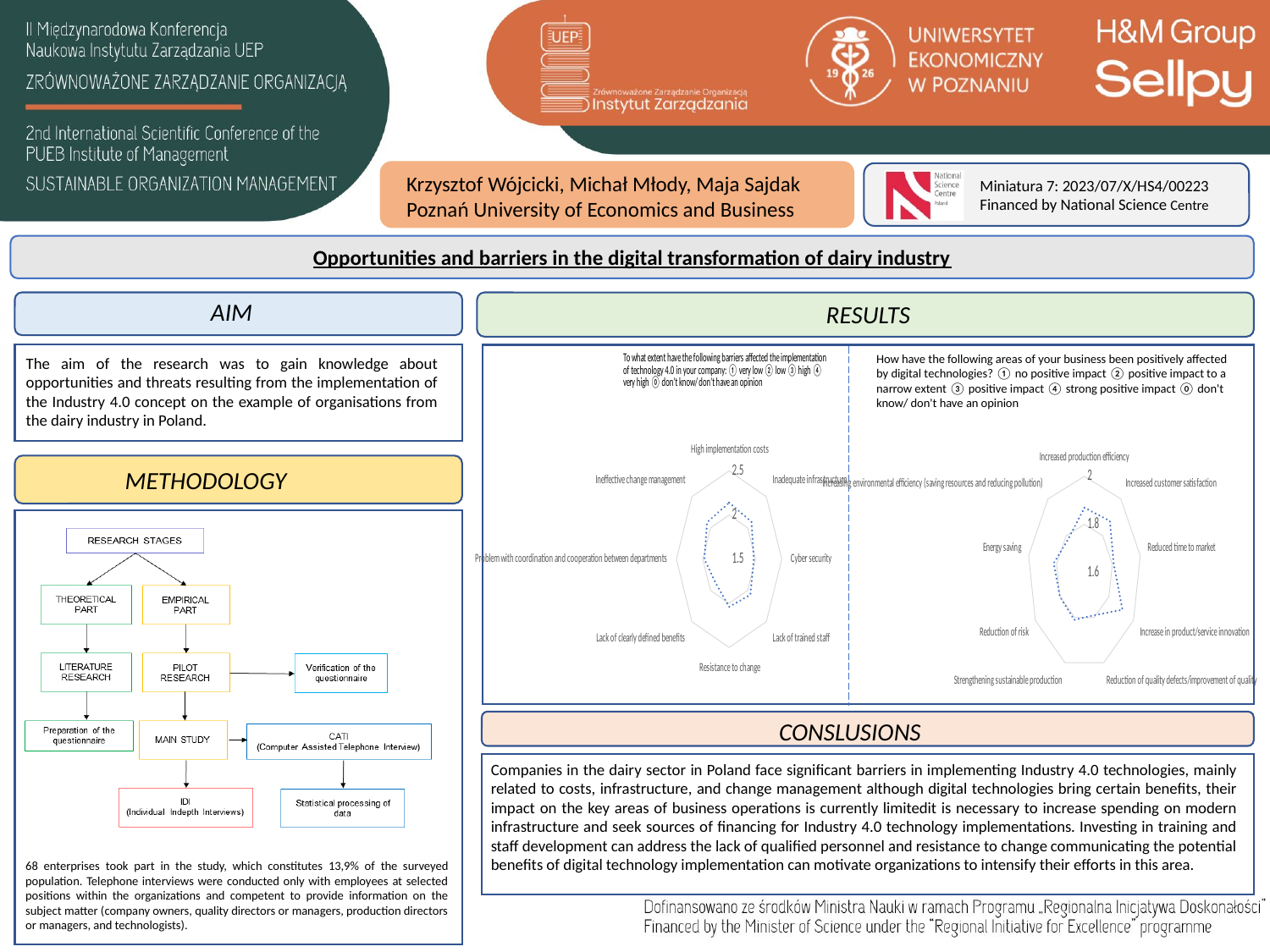
What kind of chart is the right chart in the RESULTS section, about areas positively affected by digital technologies? radar chart In the right RESULTS chart, is the value for Increased production efficiency greater or less than 2? less What is the highest axis tick value shown on the left RESULTS chart about barriers? 2.5 In the right RESULTS chart, is the value for Energy saving greater or less than 2? less What kind of chart is the left chart in the RESULTS section, about barriers to technology 4.0 implementation? radar chart In the right RESULTS chart about positively affected business areas, how many categories are plotted? 9 What is the highest axis tick value shown on the right RESULTS chart about positively affected areas? 2 In the left RESULTS chart about barriers, how many barrier categories are plotted? 8